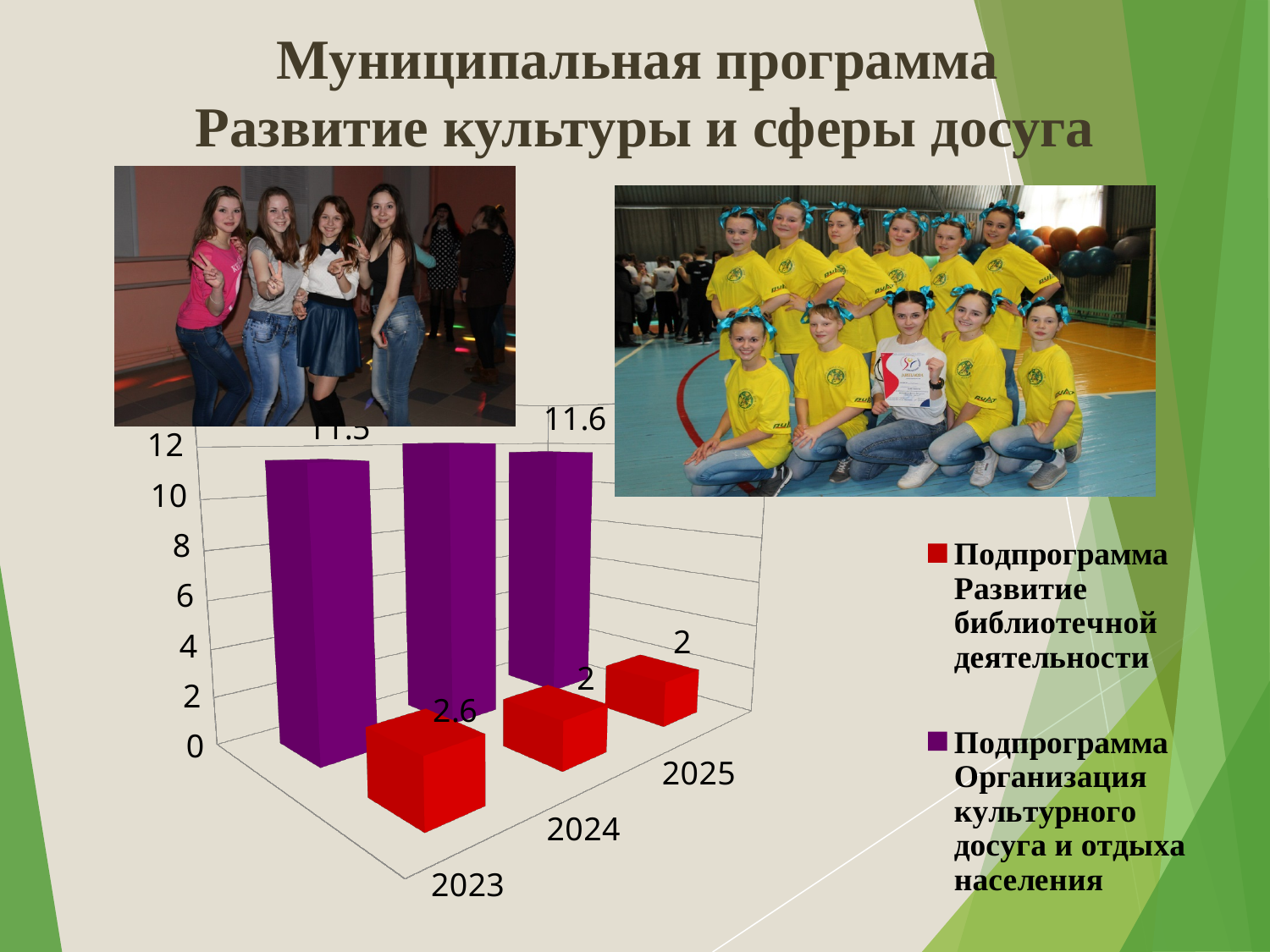
What is the value for Подпрограмма Организация культурного досуга и отдыха населения in 2025? 11.6 How many years are shown on the x axis of the chart? 3 What is the difference between the 2023 and 2025 values for Подпрограмма Развитие библиотечной деятельности? 0.6 In 2025, which subprogramme has the larger value? Подпрограмма Организация культурного досуга и отдыха населения Is the 2023 value for Подпрограмма Организация культурного досуга и отдыха населения greater or less than 10? greater What is the value for Подпрограмма Развитие библиотечной деятельности in 2024? 2 What is the value for Подпрограмма Развитие библиотечной деятельности in 2023? 2.6 How many series does the legend list? 2 Which colour represents Подпрограмма Развитие библиотечной деятельности in the chart? Red In which year is the value for Подпрограмма Развитие библиотечной деятельности highest? 2023 Is the 2024 value for Подпрограмма Развитие библиотечной деятельности greater or less than 4? less What kind of chart is shown on the slide? Bar chart